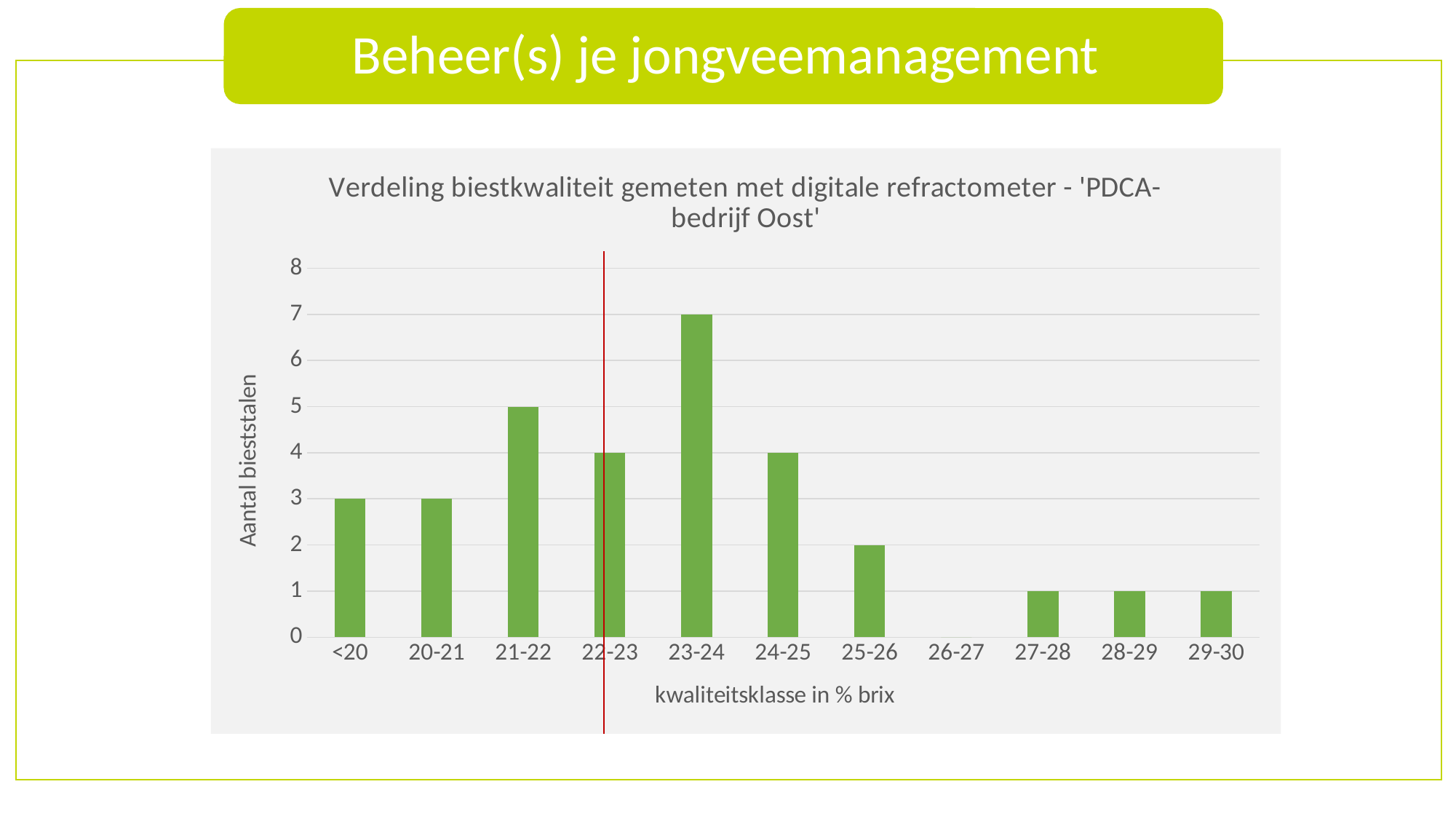
What is the difference in number of samples between the 23-24 class and the 21-22 class? 2 What kind of chart is shown on the slide? bar chart What is the label of the y axis? Aantal bieststalen How many samples are in the 23-24 class? 7 How many quality classes (categories) are shown on the x axis? 11 What is the label of the x axis? kwaliteitsklasse in % brix Which quality class has no samples at all? 26-27 Which has more samples, the 22-23 class or the 25-26 class? 22-23 Do the values rise or fall from the 23-24 class to the 26-27 class? fall Which quality class has the highest number of colostrum samples (Aantal bieststalen)? 23-24 How many samples are in the 25-26 class? 2 How many samples are in the 21-22 class? 5